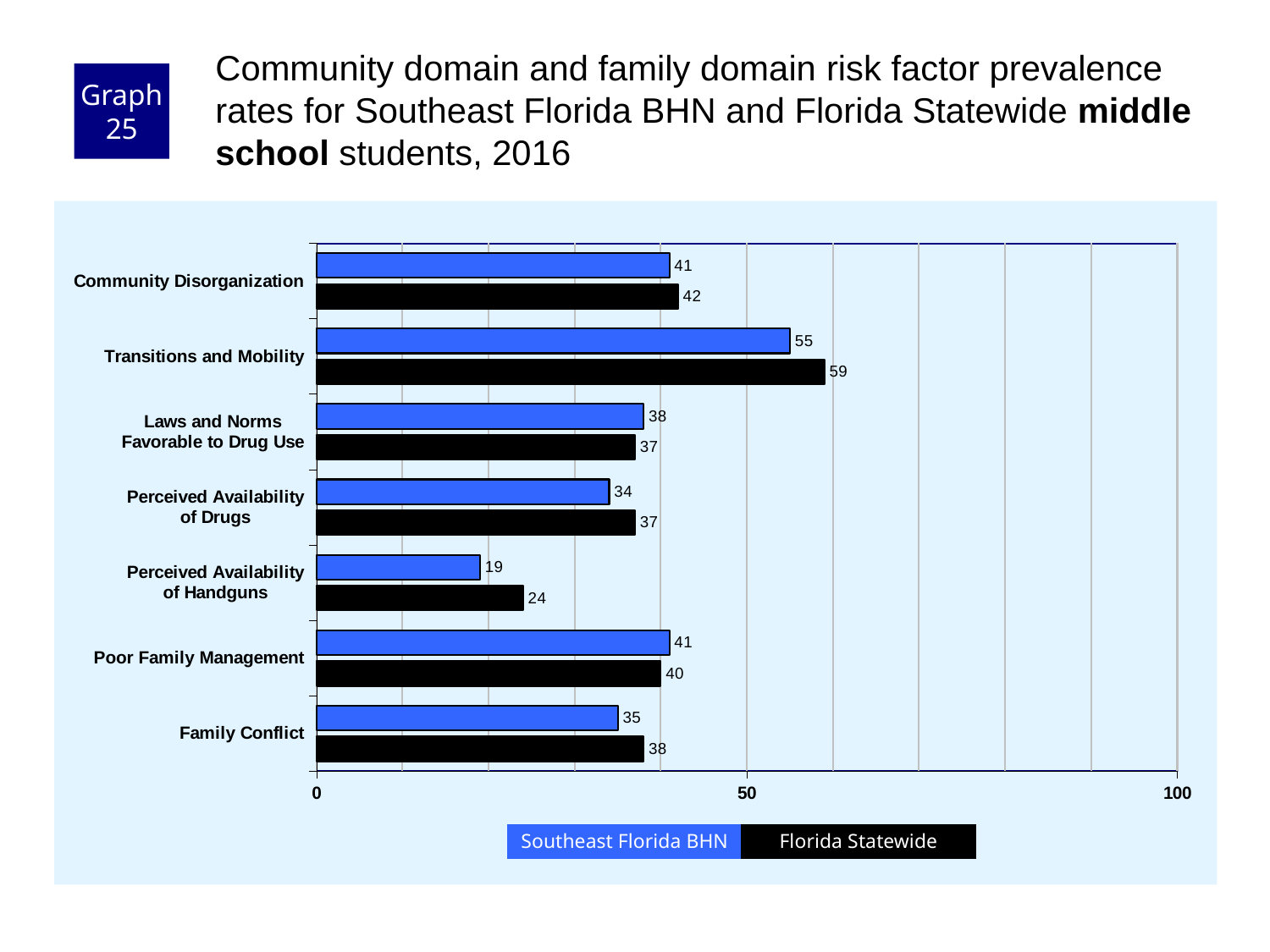
Is the Florida Statewide value for Transitions and Mobility greater or less than 50? greater How many risk factor categories are shown on the chart? 7 What is the difference between the Florida Statewide and Southeast Florida BHN values for Transitions and Mobility? 4 What kind of chart is shown on the slide? bar chart What is the Southeast Florida BHN value for Family Conflict? 35 Which risk factor has the lowest Southeast Florida BHN value? Perceived Availability of Handguns Which risk factor has the highest Florida Statewide value? Transitions and Mobility What is the Florida Statewide value for Perceived Availability of Handguns? 24 Which series is shown in black in the legend? Florida Statewide What is the Southeast Florida BHN value for Transitions and Mobility? 55 How many series does the legend list? 2 For Perceived Availability of Drugs, which is larger: the Southeast Florida BHN value or the Florida Statewide value? Florida Statewide